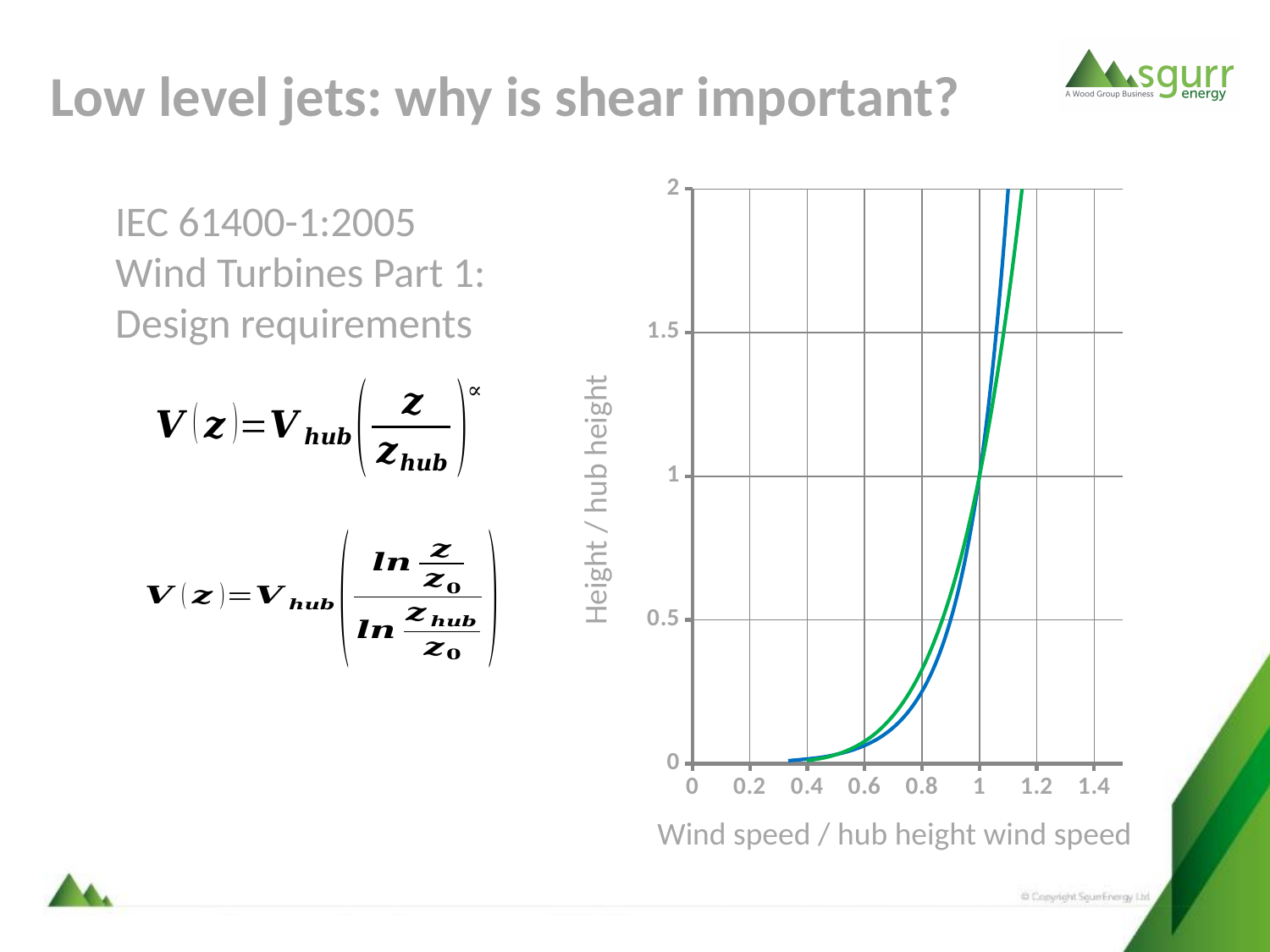
What kind of chart is shown on the slide? line chart At a wind speed ratio of 0.8, is the height / hub height of the curves greater or less than 0.5? less What is the highest value shown on the x axis? 1.4 At a wind speed ratio of 0.6, is the height / hub height of the curves greater or less than 0.5? less What is the title of the y axis of the chart? Height / hub height What is the height / hub height value where the two curves cross? 1 Does height / hub height rise or fall as wind speed / hub height wind speed increases along the x axis? rise How many curves are plotted on the chart? 2 What is the title of the x axis of the chart? Wind speed / hub height wind speed How many tick labels are shown on the x axis? 8 What is the highest value shown on the y axis? 2 At what wind speed ratio do the two curves cross each other? 1